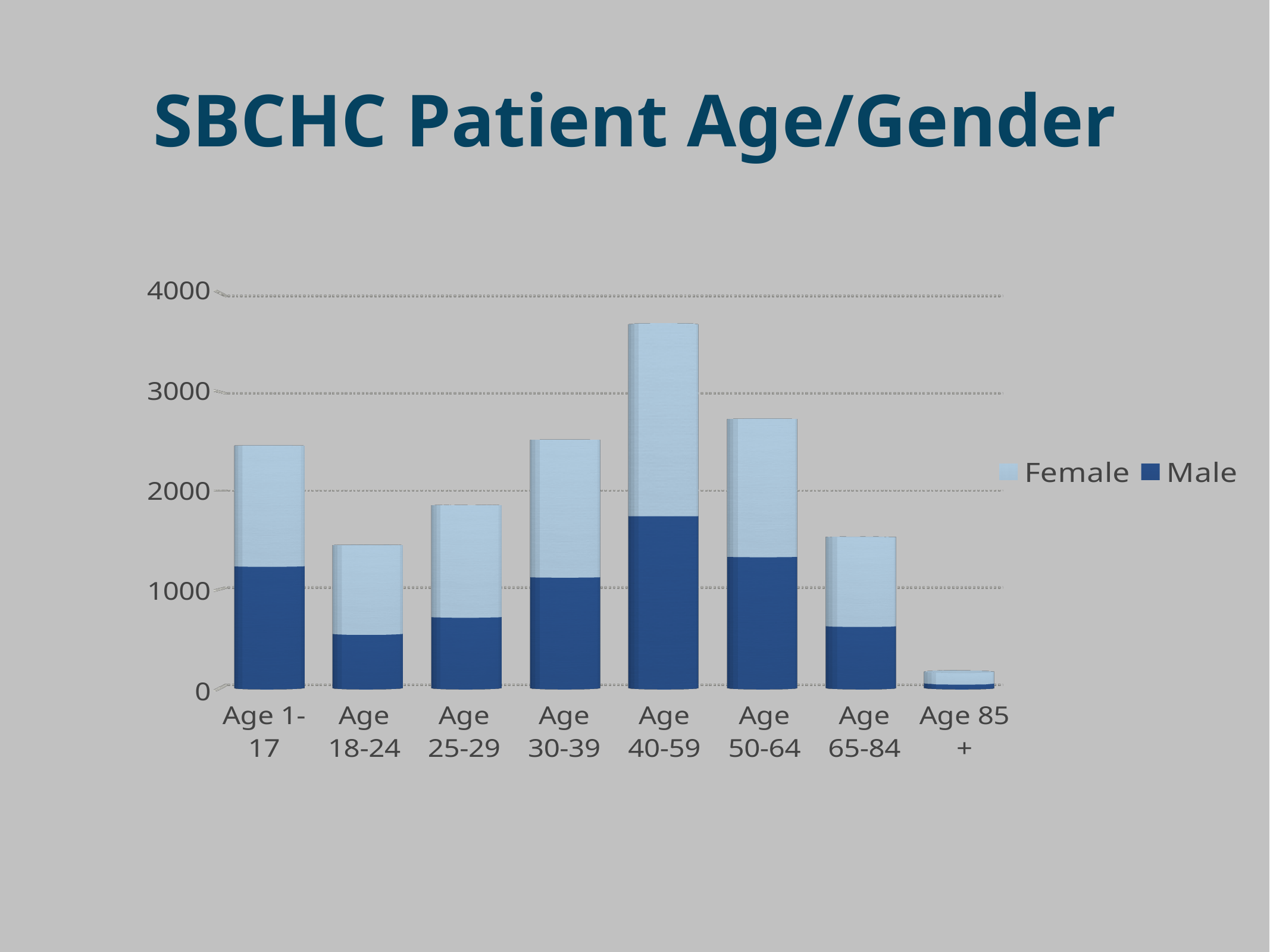
How many age categories are shown on the x axis? 8 Which age group has the tallest stacked bar? Age 40-59 What is the title of the slide? SBCHC Patient Age/Gender What kind of chart is shown on the slide? Stacked bar chart Which age group has the shortest stacked bar? Age 85 + Which has the taller stacked bar, Age 50-64 or Age 65-84? Age 50-64 Is the Male value for Age 40-59 greater or less than 1000? greater Is the total bar height for Age 18-24 greater or less than 2000? less Is the total bar height for Age 85 + greater or less than 1000? less How many series does the legend list? 2 Which has the taller stacked bar, Age 30-39 or Age 18-24? Age 30-39